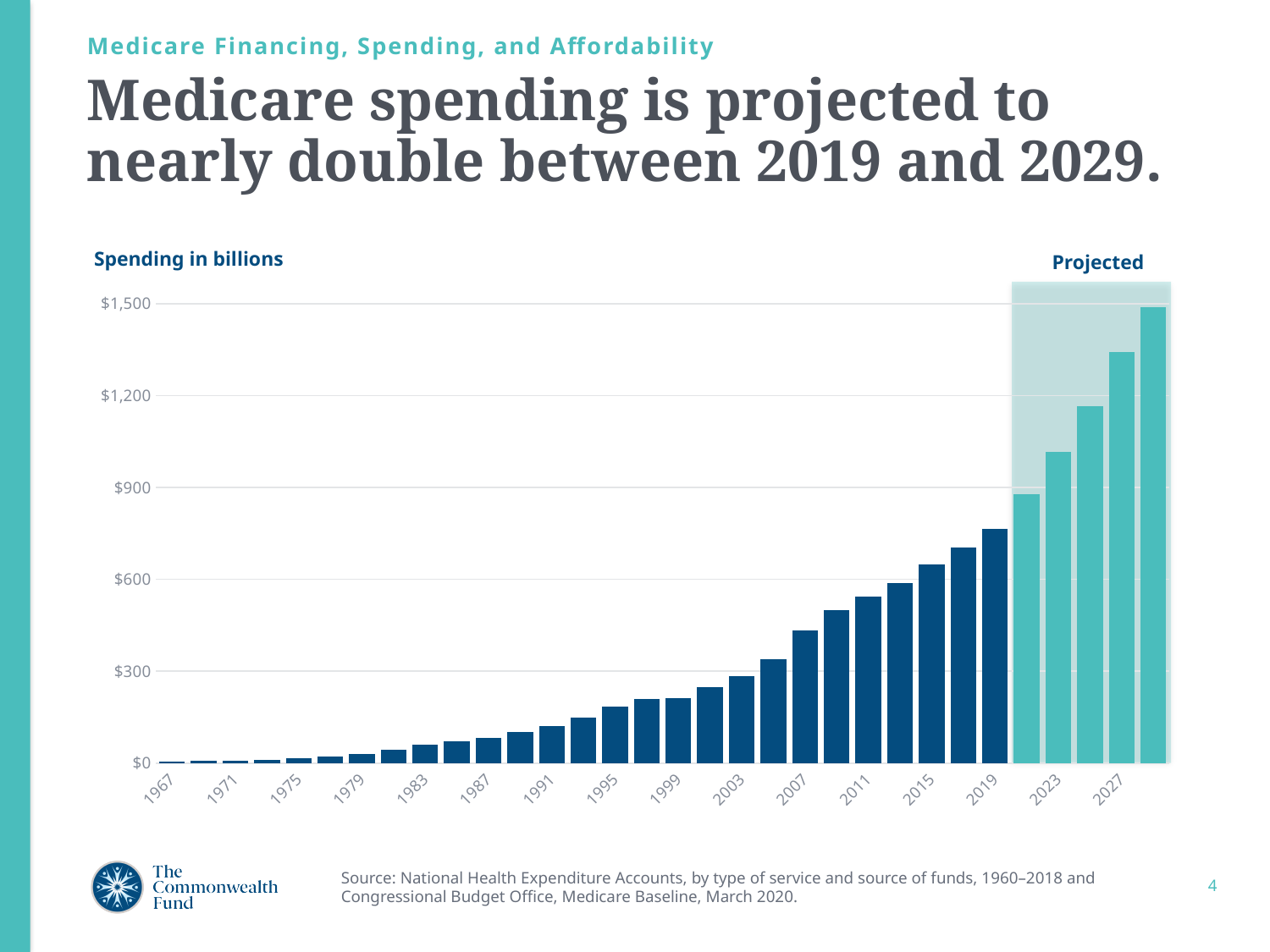
Do the values generally rise or fall from 1967 to the rightmost bar? Rise Is the value for 2027 greater or less than $1,200? greater What label appears above the shaded region on the right side of the chart? Projected Which is larger, the value for 2007 or the value for 2015? 2015 Is the value for 2019 greater or less than $600? greater Is the value for 2019 greater or less than $900? less What kind of chart is shown on the slide? Bar chart Which labeled year on the x axis has the lowest bar? 1967 How many year labels are shown on the x axis? 16